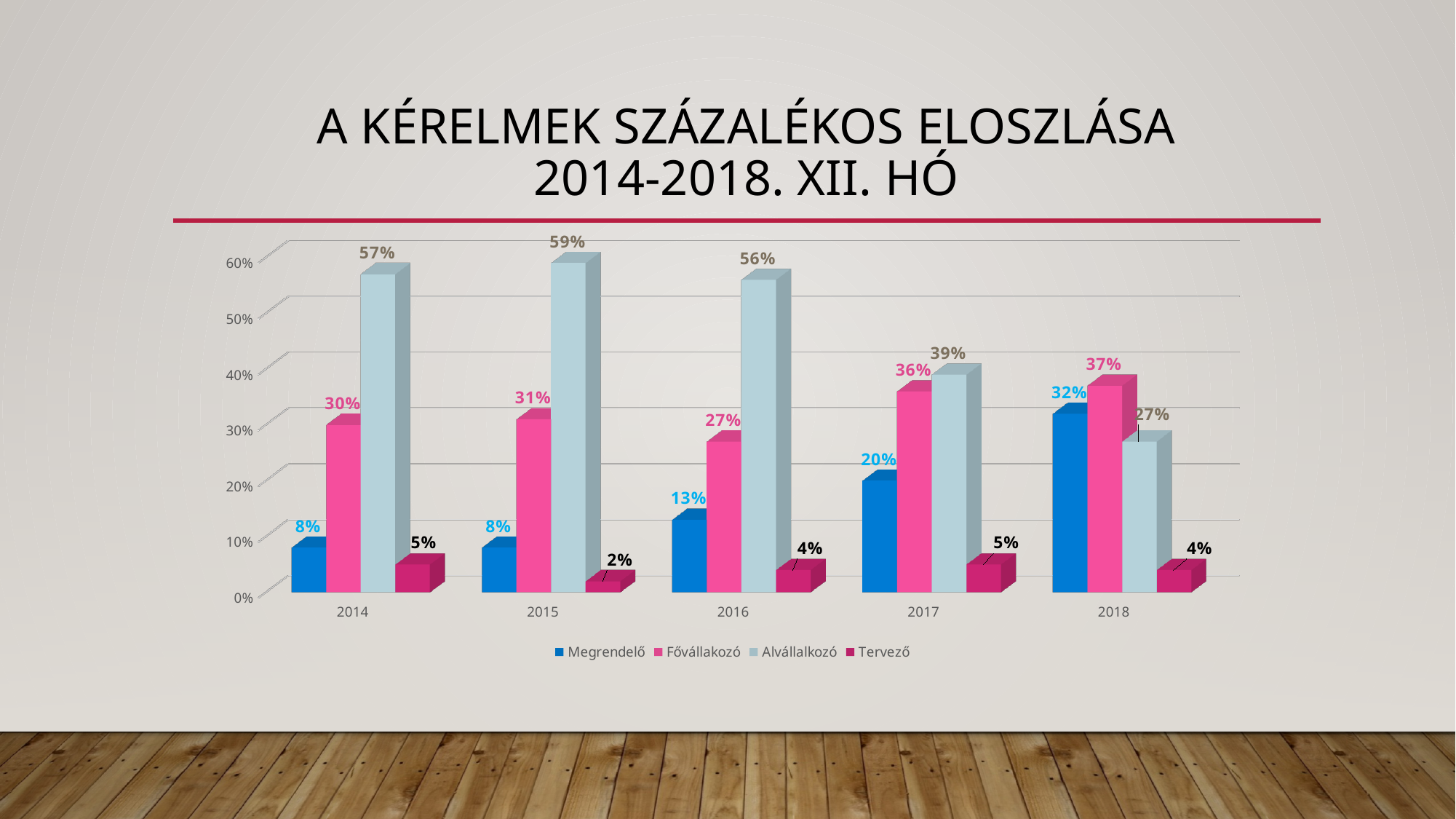
What is the value for Fővállakozó in 2017? 36% What kind of chart is shown on the slide? Bar chart Which is larger in 2018, Fővállakozó or Alvállalkozó? Fővállakozó How many years are shown on the x axis? 5 What is the value for Megrendelő in 2018? 32% In which year is the Alvállalkozó value highest? 2015 What is the value for Alvállalkozó in 2015? 59% In which year is the Megrendelő value lowest? 2014 and 2015 What is the difference between the Alvállalkozó and Fővállakozó values in 2014? 27% What is the value for Tervező in 2015? 2% How many series does the legend list? 4 Does the Megrendelő value rise or fall from 2015 to 2018? Rise